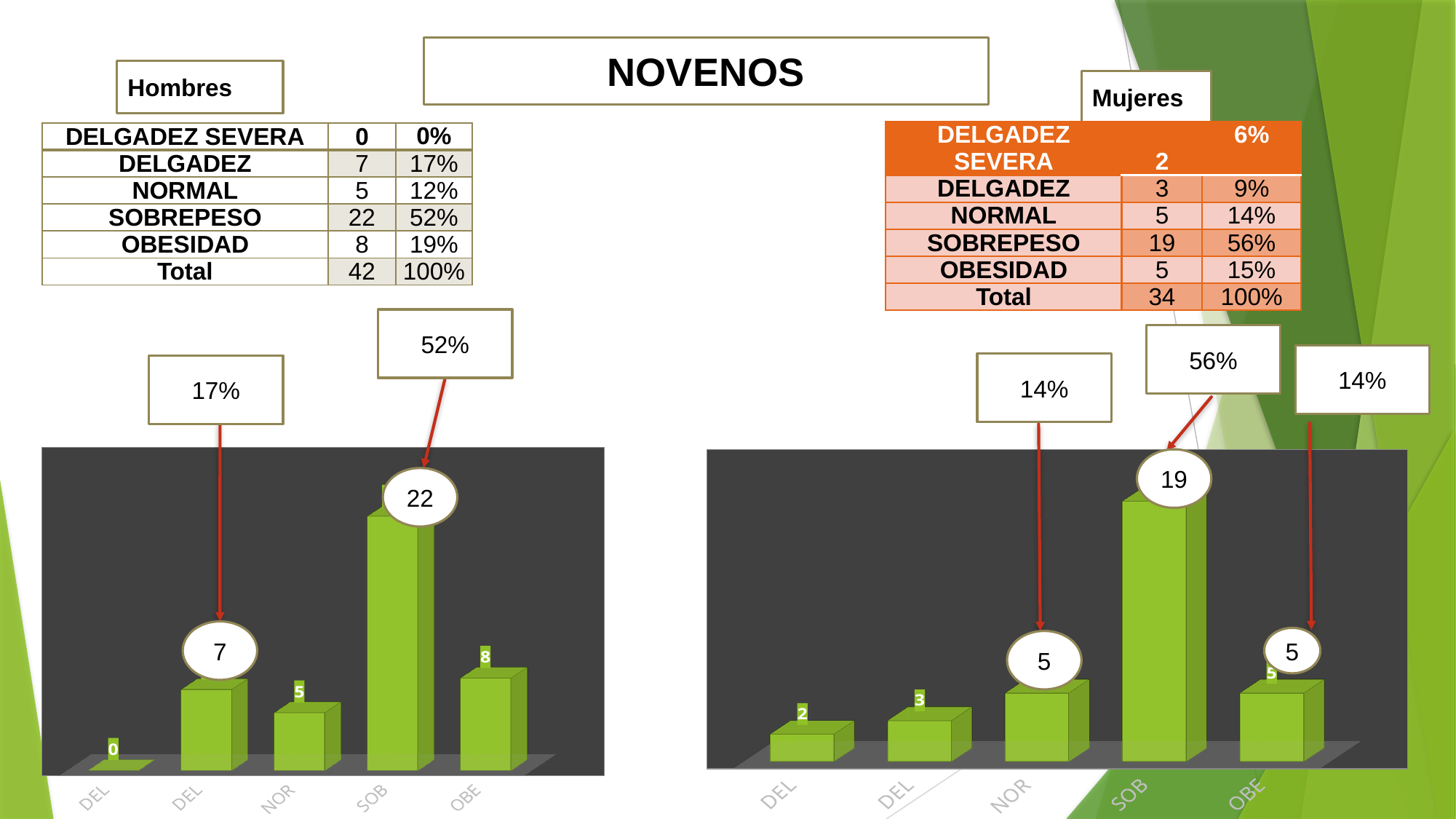
What percentage is shown in the callout box pointing to the SOB bar on the Mujeres chart (right)? 56% On the Mujeres chart (right), what is the difference between the SOB bar and the NOR bar? 14 On the Mujeres chart (right), what is the value of the NOR bar? 5 On the Hombres chart (left), what is the value of the OBE bar? 8 On the Hombres chart (left), which category has the highest bar? SOB On the Mujeres chart (right), what is the value of the SOB bar? 19 On the Hombres chart (left), what is the difference between the SOB bar and the OBE bar? 14 On the Mujeres chart (right), which category has the lowest bar? DEL (the first bar, DELGADEZ SEVERA) Which is larger: the SOB bar on the Hombres chart or the SOB bar on the Mujeres chart? Hombres (22) How many bars are shown on the Hombres chart (left)? 5 On the Hombres chart (left), what is the value of the SOB bar? 22 What type of chart is used for the Mujeres data (right)? Bar chart